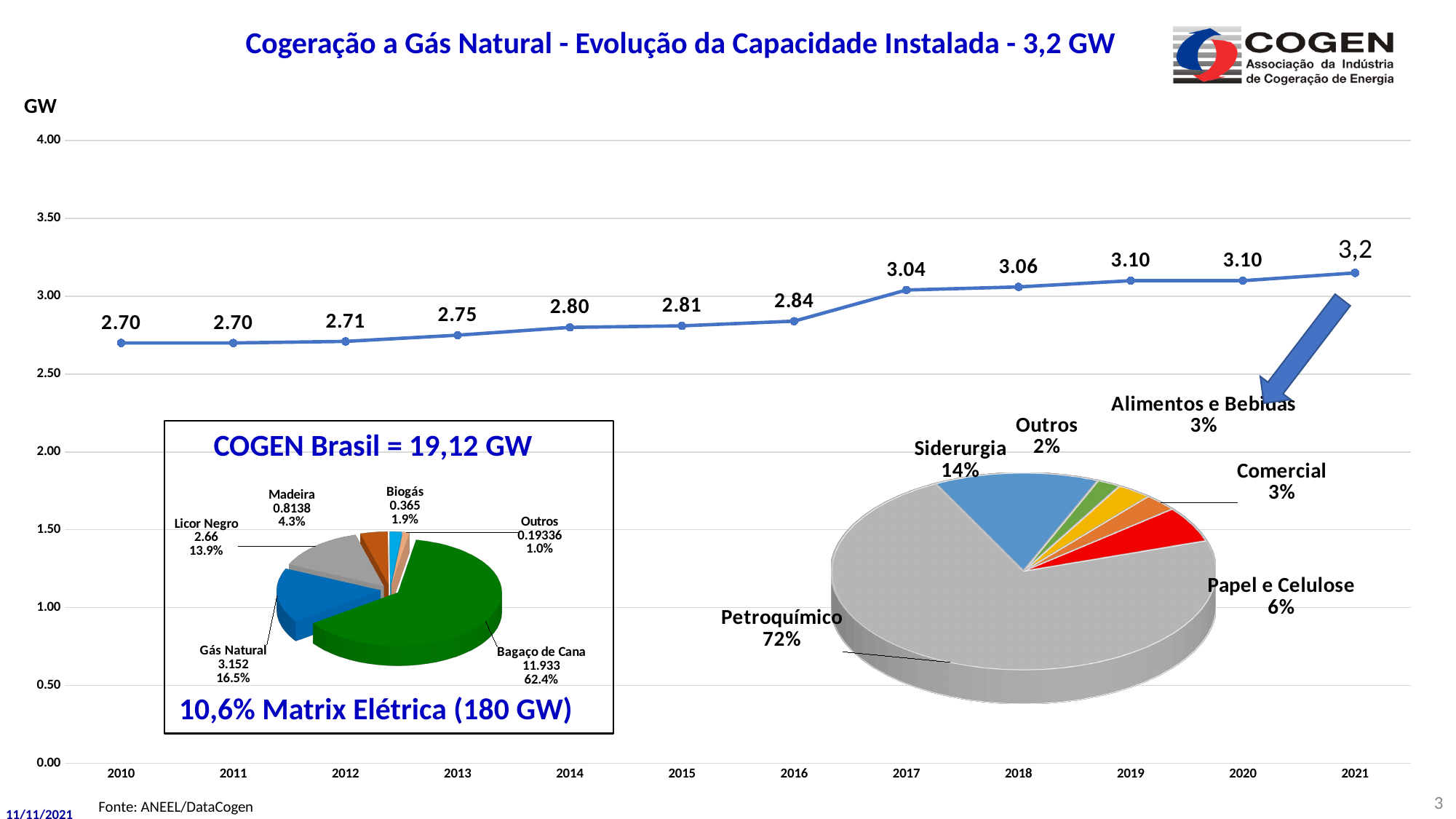
In the line chart 'Cogeração a Gás Natural - Evolução da Capacidade Instalada', what is the value for 2017? 3.04 In the pie chart 'COGEN Brasil = 19,12 GW', what is the value for Gás Natural? 3.152 In the pie chart on the right of the slide, what share does Petroquímico have? 72% In the line chart 'Cogeração a Gás Natural - Evolução da Capacidade Instalada', what is the difference between the values for 2018 and 2016? 0.22 In the line chart 'Cogeração a Gás Natural - Evolução da Capacidade Instalada', which year has the highest value? 2021 In the line chart 'Cogeração a Gás Natural - Evolução da Capacidade Instalada', how many years are plotted on the x axis? 12 What kind of chart is 'Cogeração a Gás Natural - Evolução da Capacidade Instalada'? line chart In the line chart 'Cogeração a Gás Natural - Evolução da Capacidade Instalada', what is the value for 2013? 2.75 In the line chart 'Cogeração a Gás Natural - Evolução da Capacidade Instalada', do the values generally rise or fall from 2010 to 2021? rise In the pie chart on the right of the slide, which is larger, Siderurgia or Papel e Celulose? Siderurgia In the pie chart 'COGEN Brasil = 19,12 GW', what share does Bagaço de Cana have? 62.4% In the pie chart 'COGEN Brasil = 19,12 GW', which category has the smallest share? Outros